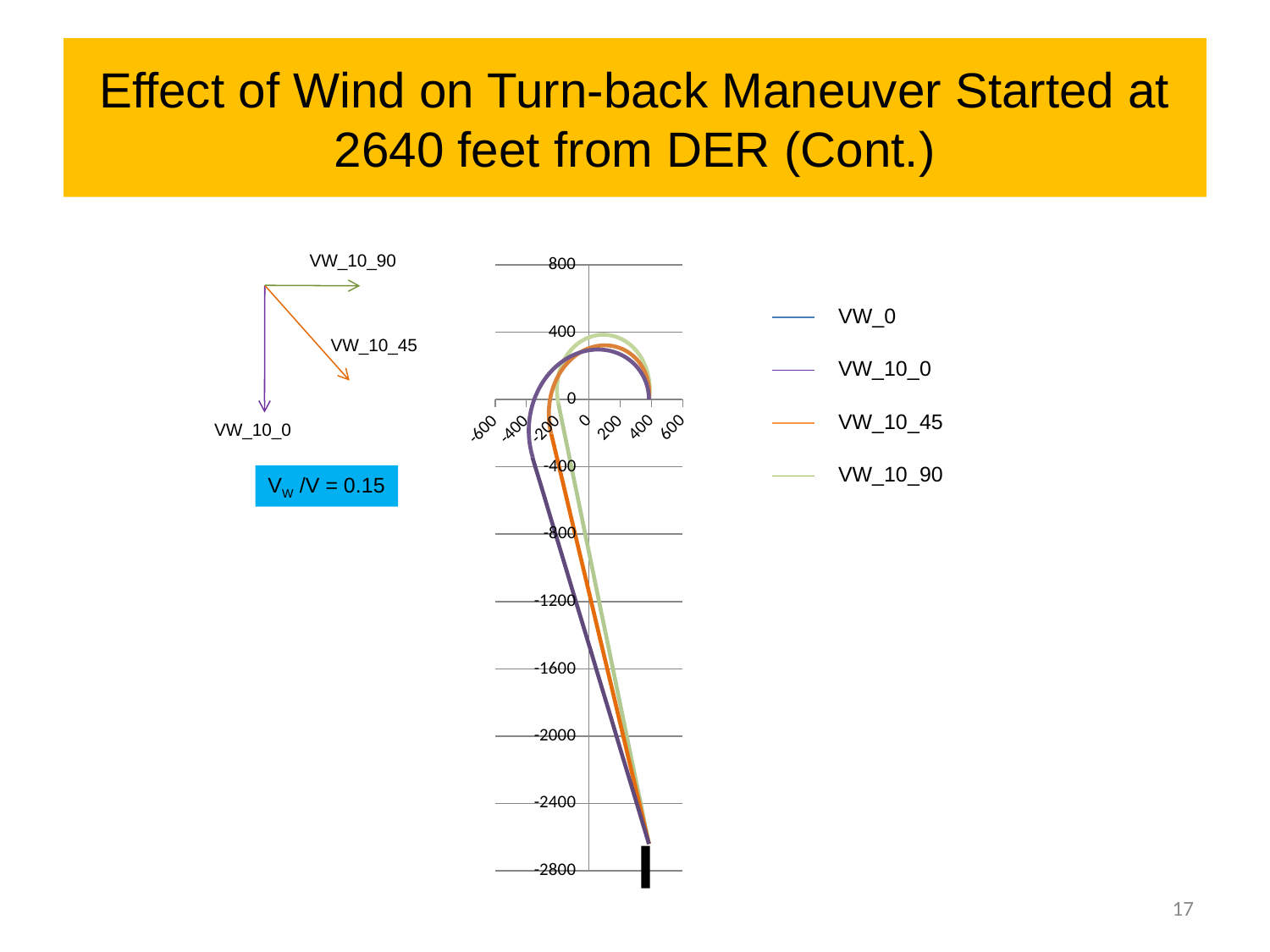
Is the lowest point of the plotted curves greater or less than -2400 on the vertical axis? less What is the lowest value shown on the vertical axis of the chart? -2800 Is the topmost point of the VW_10_90 curve greater or less than 0 on the vertical axis? greater Which series is drawn in orange on the chart? VW_10_45 Is the topmost point of the VW_10_90 curve greater or less than 800 on the vertical axis? less What kind of chart is shown on the slide? line chart Which series is listed last in the chart legend? VW_10_90 How many series does the chart legend list? 4